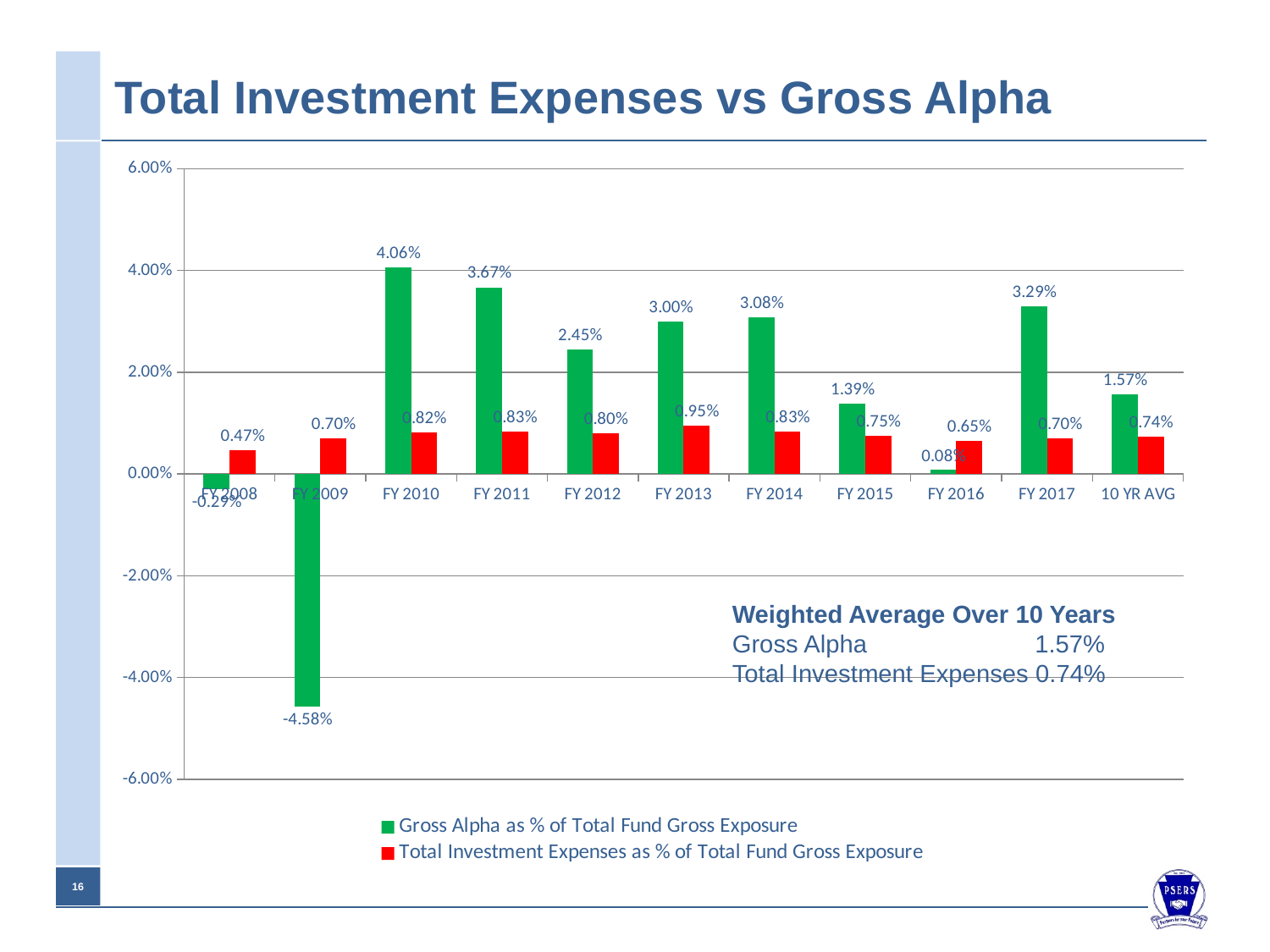
Which is larger, the Gross Alpha for FY 2014 or the Gross Alpha for FY 2015? FY 2014 What is the Gross Alpha value shown for the 10 YR AVG category? 1.57% What is the Gross Alpha as % of Total Fund Gross Exposure for FY 2010? 4.06% What is the Total Investment Expenses as % of Total Fund Gross Exposure for FY 2013? 0.95% Which category has the lowest Total Investment Expenses as % of Total Fund Gross Exposure? FY 2008 How many categories are shown on the x axis of the chart? 11 How many series does the legend list? 2 Which fiscal year has the lowest Gross Alpha as % of Total Fund Gross Exposure? FY 2009 How much higher is the Gross Alpha in FY 2010 than in FY 2011? 0.39% What type of chart is shown on the slide? Bar chart Which fiscal year has the highest Gross Alpha as % of Total Fund Gross Exposure? FY 2010 What is the difference between Gross Alpha and Total Investment Expenses for the 10 YR AVG category? 0.83%